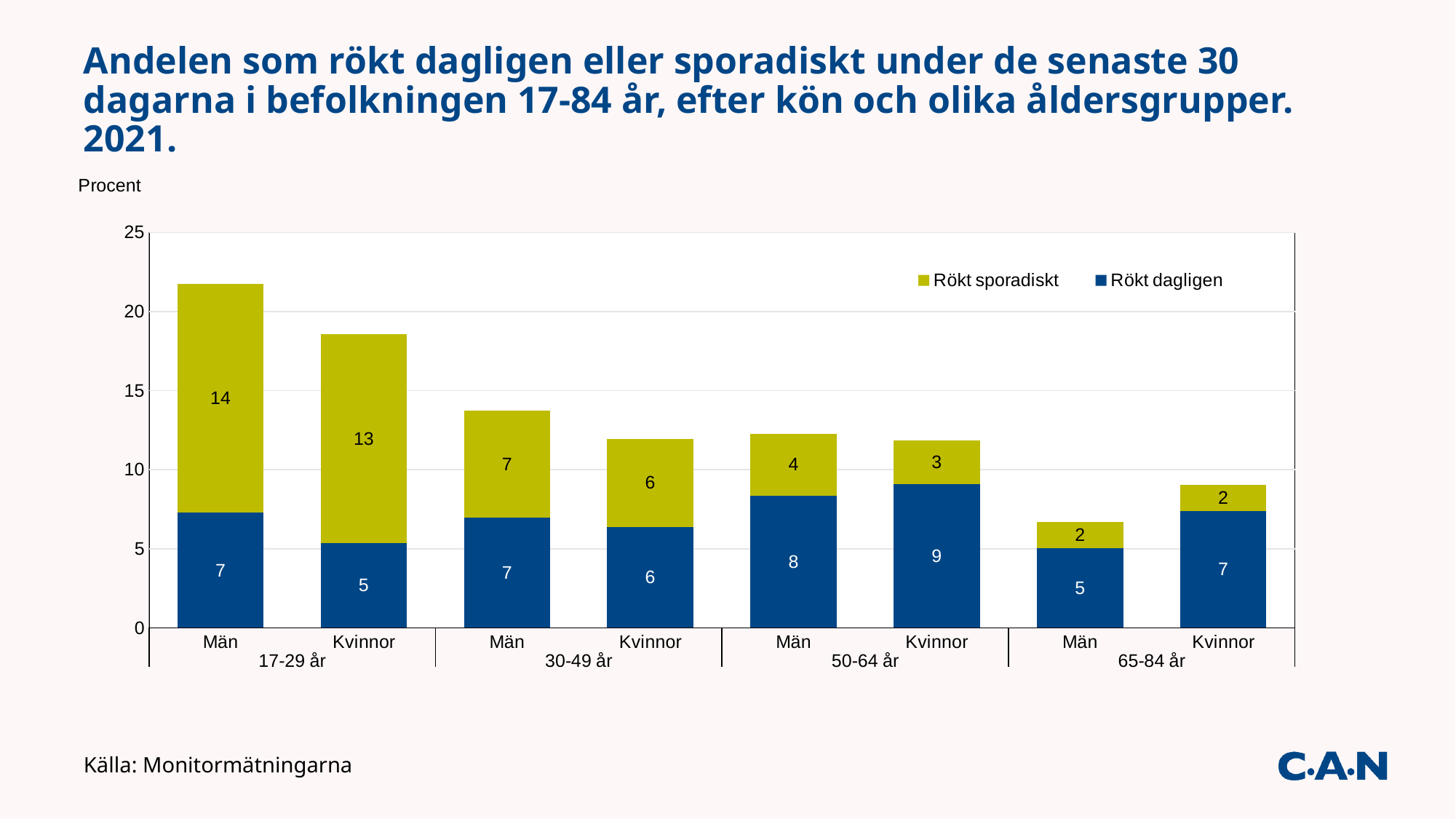
Which bar has the highest value for Rökt dagligen? Kvinnor, 50-64 år What is the value of Rökt dagligen for Män in the 65-84 år group? 5 What kind of chart is shown on the slide? Stacked bar chart Which bar has the highest value for Rökt sporadiskt? Män, 17-29 år Is the total height of the bar for Män in the 17-29 år group greater or less than 20? greater How many bars are plotted in the chart? 8 What is the value of Rökt dagligen for Kvinnor in the 50-64 år group? 9 What is the value of Rökt sporadiskt for Män in the 17-29 år group? 14 How many series does the legend list? 2 What is the difference between the Rökt sporadiskt values for Män and Kvinnor in the 17-29 år group? 1 In the 50-64 år group, which has the larger Rökt dagligen value, Män or Kvinnor? Kvinnor What are the two series named in the legend? Rökt sporadiskt and Rökt dagligen